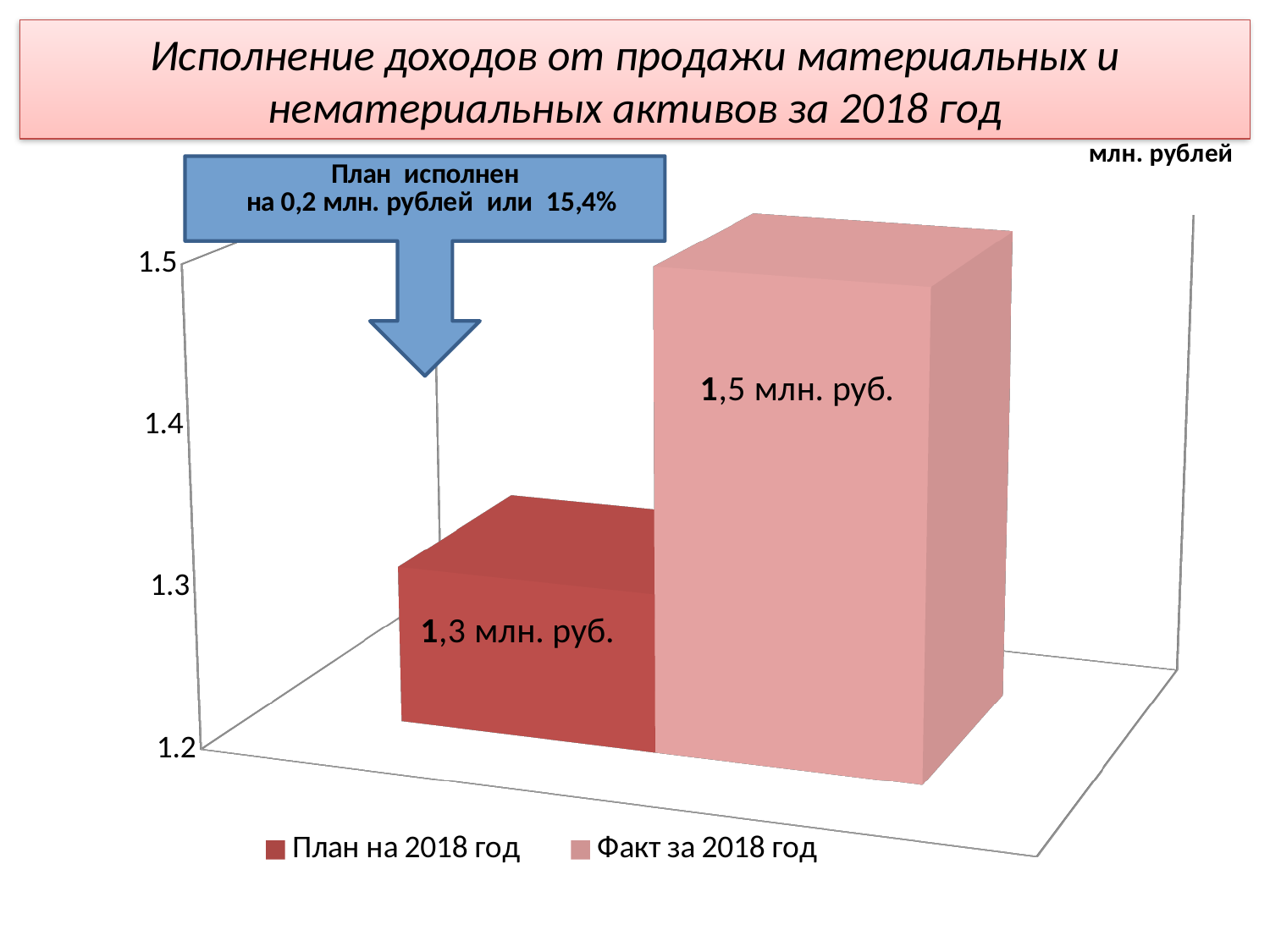
Which bar shows the lowest value? План на 2018 год Which bar shows the highest value? Факт за 2018 год How many series does the legend list? 2 Is the value for План на 2018 год greater or less than 1.4? less How many bars are plotted on the chart? 2 Which series has the higher value, План на 2018 год or Факт за 2018 год? Факт за 2018 год What is the value for План на 2018 год? 1,3 млн. руб. What is the difference between Факт за 2018 год and План на 2018 год? 0,2 млн. руб. What is the value for Факт за 2018 год? 1,5 млн. руб. Is the value for Факт за 2018 год greater or less than 1.4? greater What unit of measurement is indicated for the chart values? млн. рублей What kind of chart is shown on the slide? Bar chart